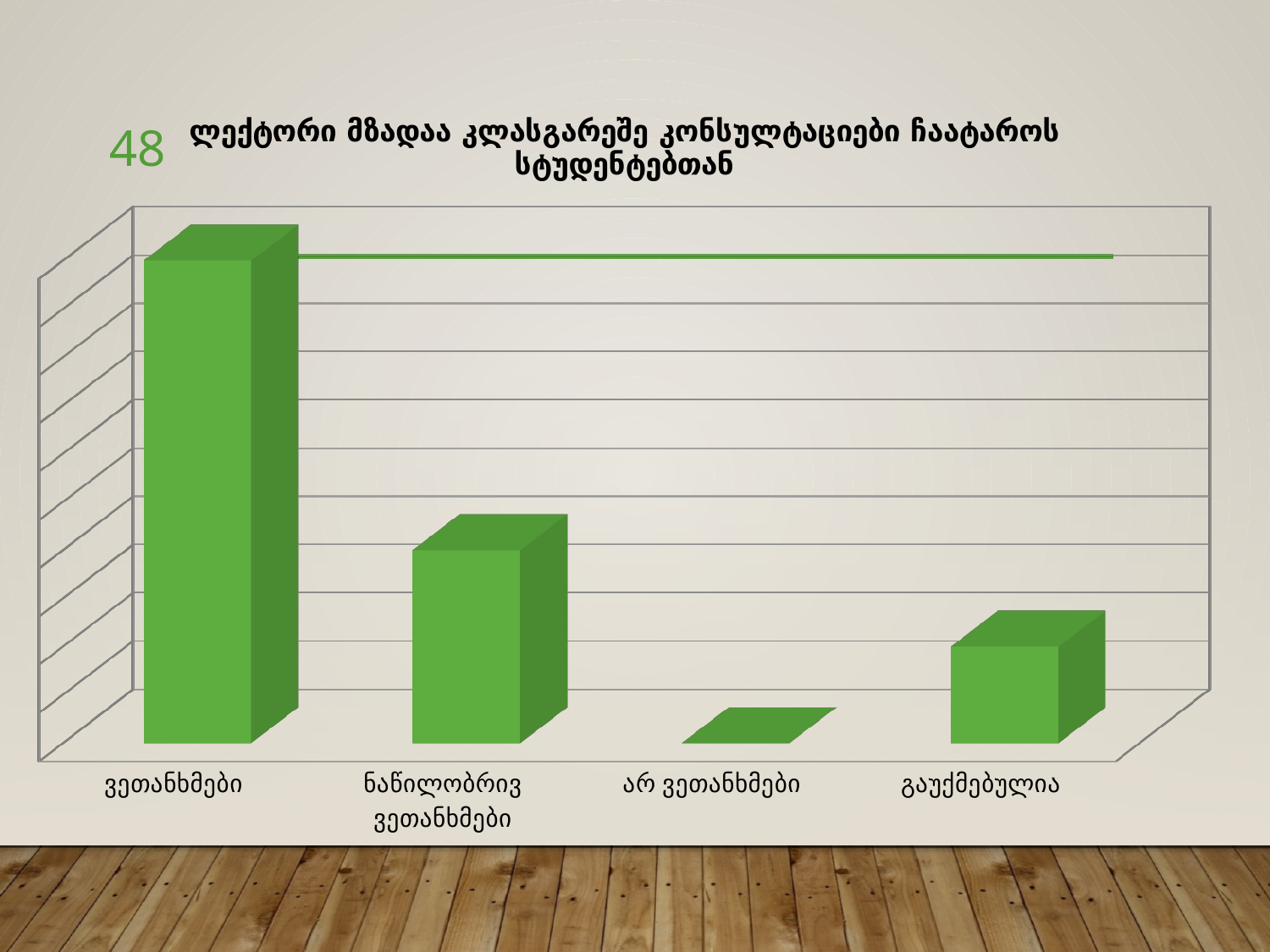
Which is larger, the bar for გაუქმებულია or the bar for არ ვეთანხმები? გაუქმებულია Which category has the highest bar in the chart? ვეთანხმები Which category has the lowest bar in the chart? არ ვეთანხმები What is the label of the second category on the x axis? ნაწილობრივ ვეთანხმები What kind of chart is shown on the slide? bar chart Do the bar values rise or fall from ვეთანხმები to არ ვეთანხმები along the x axis? fall Which is larger, the bar for ნაწილობრივ ვეთანხმები or the bar for გაუქმებულია? ნაწილობრივ ვეთანხმები What colour are the bars in the chart? green How many categories are shown on the x axis of the chart? 4 What is the title of the chart? ლექტორი მზადაა კლასგარეშე კონსულტაციები ჩაატაროს სტუდენტებთან Which is larger, the bar for ვეთანხმები or the bar for ნაწილობრივ ვეთანხმები? ვეთანხმები What is the label of the last category on the x axis? გაუქმებულია